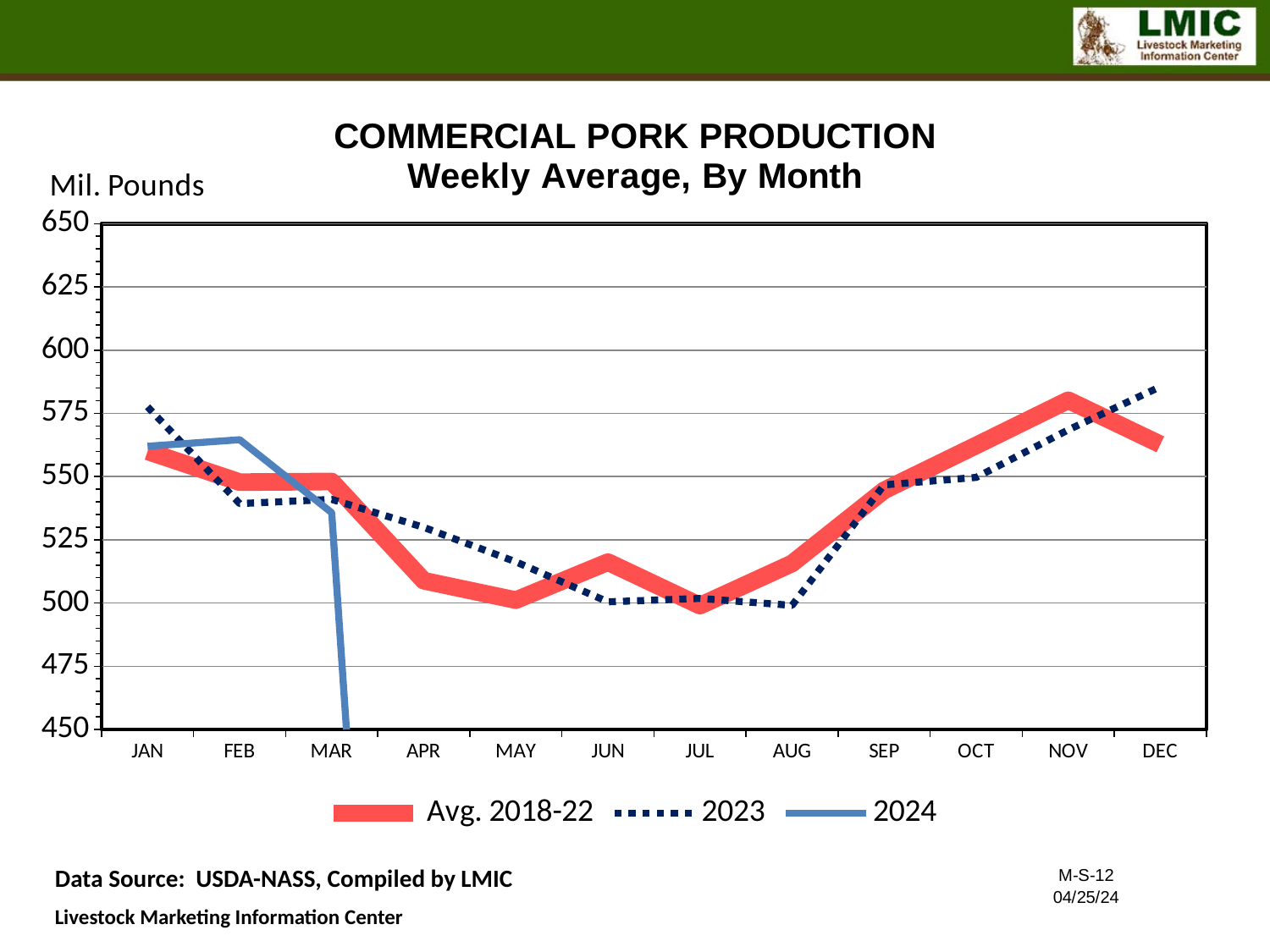
In which month does the Avg. 2018-22 series reach its highest value? NOV Is the Avg. 2018-22 value for APR greater or less than 525? less Is the 2023 value for AUG greater or less than 525? less In FEB, which series has the higher value, 2024 or 2023? 2024 Is the 2024 value for FEB greater or less than 550? greater What is the title of the chart? COMMERCIAL PORK PRODUCTION Weekly Average, By Month What is the unit label shown on the y axis? Mil. Pounds How many series does the legend list? 3 How many months are shown along the x axis? 12 What kind of chart is shown on the slide? Line chart In JAN, which series has the higher value, 2023 or Avg. 2018-22? 2023 Does the 2023 series rise or fall from JAN to JUN? fall